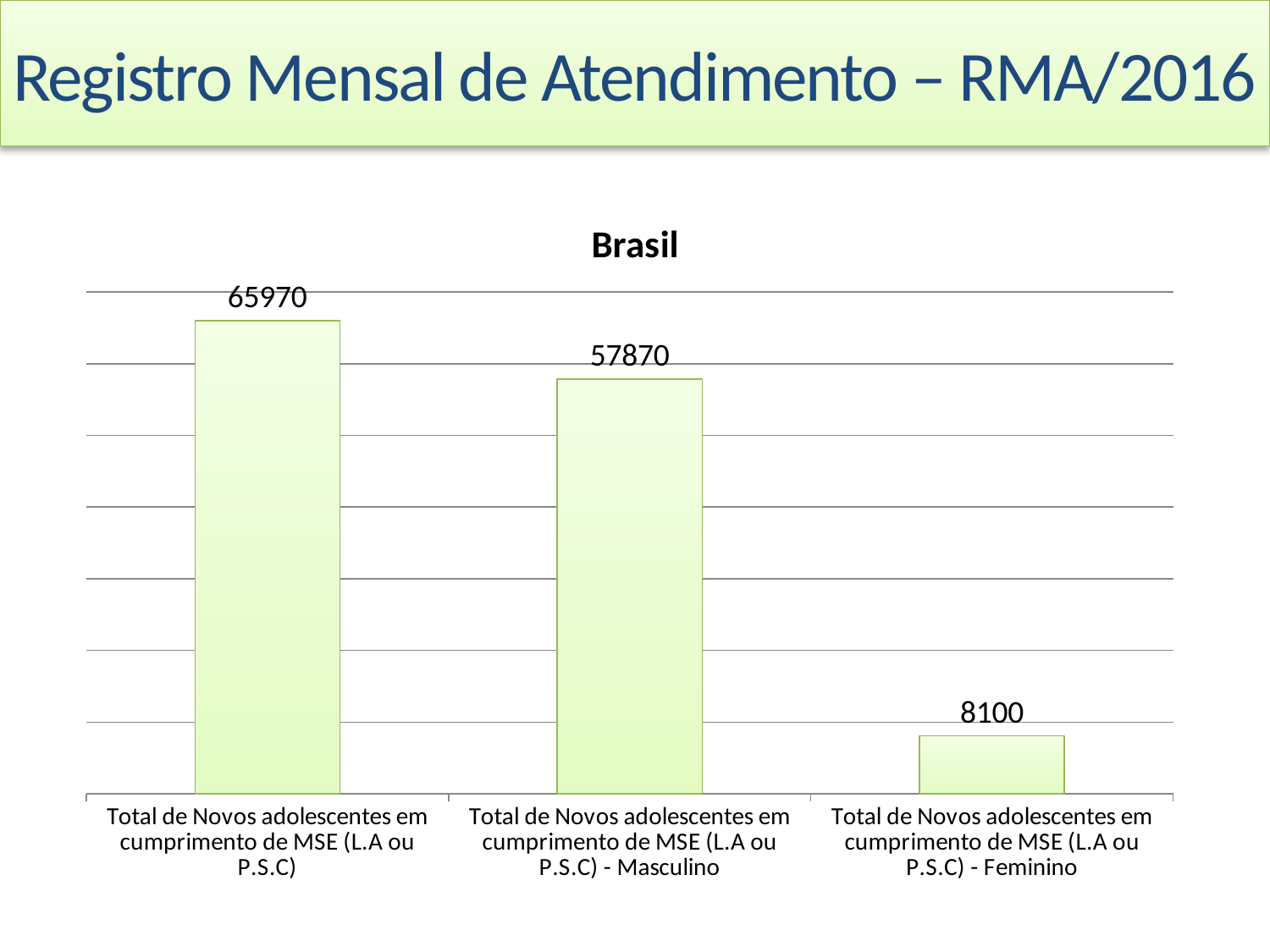
What is the value for "Total de Novos adolescentes em cumprimento de MSE (L.A ou P.S.C) - Feminino"? 8100 What is the difference between the overall total (65970) and the Masculino value? 8100 What is the title of the chart? Brasil What is the difference between the Masculino value and the Feminino value? 49770 What is the value for "Total de Novos adolescentes em cumprimento de MSE (L.A ou P.S.C)"? 65970 What kind of chart is shown on the slide? Bar chart Which category has the lowest value? Total de Novos adolescentes em cumprimento de MSE (L.A ou P.S.C) - Feminino What is the value for "Total de Novos adolescentes em cumprimento de MSE (L.A ou P.S.C) - Masculino"? 57870 Which is larger, the Masculino value or the Feminino value? Masculino Which category has the highest value? Total de Novos adolescentes em cumprimento de MSE (L.A ou P.S.C) How many bars are shown in the chart? 3 Do the values rise or fall from left to right across the categories? Fall